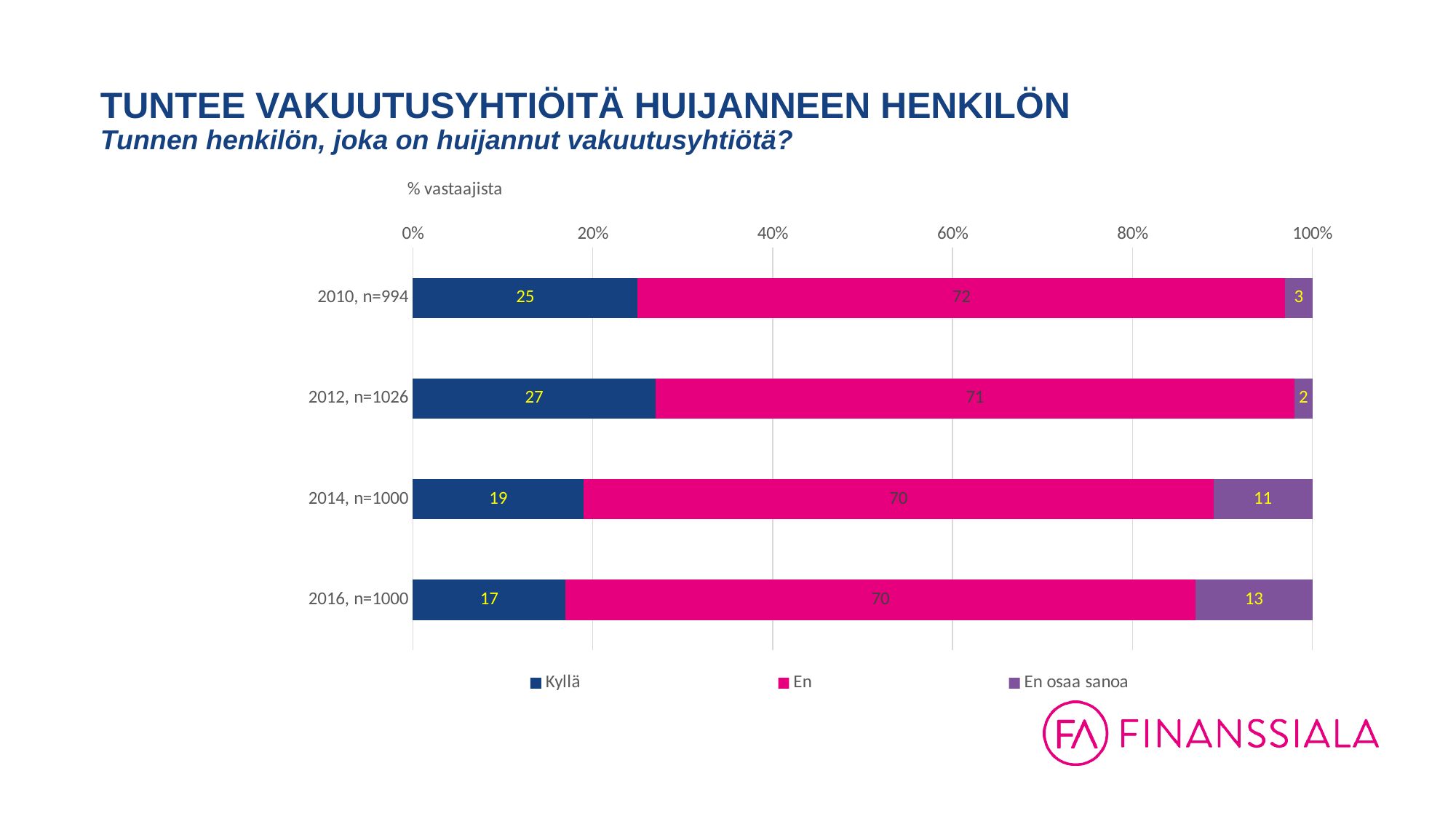
Do the Kyllä values rise or fall from 2012, n=1026 to 2016, n=1000? Fall How many categories are shown on the chart? 4 What kind of chart is shown on the slide? Stacked bar chart Which category has the highest value for Kyllä? 2012, n=1026 What is the value for Kyllä in 2010, n=994? 25 Which category has the lowest value for En osaa sanoa? 2012, n=1026 What is the value for En osaa sanoa in 2016, n=1000? 13 How many series does the legend list? 3 What is the value for En in 2014, n=1000? 70 What is the difference between the Kyllä values for 2010, n=994 and 2016, n=1000? 8 What is the total of the stacked bar for 2012, n=1026? 100 Which is larger: the En osaa sanoa value for 2014, n=1000 or for 2010, n=994? 2014, n=1000